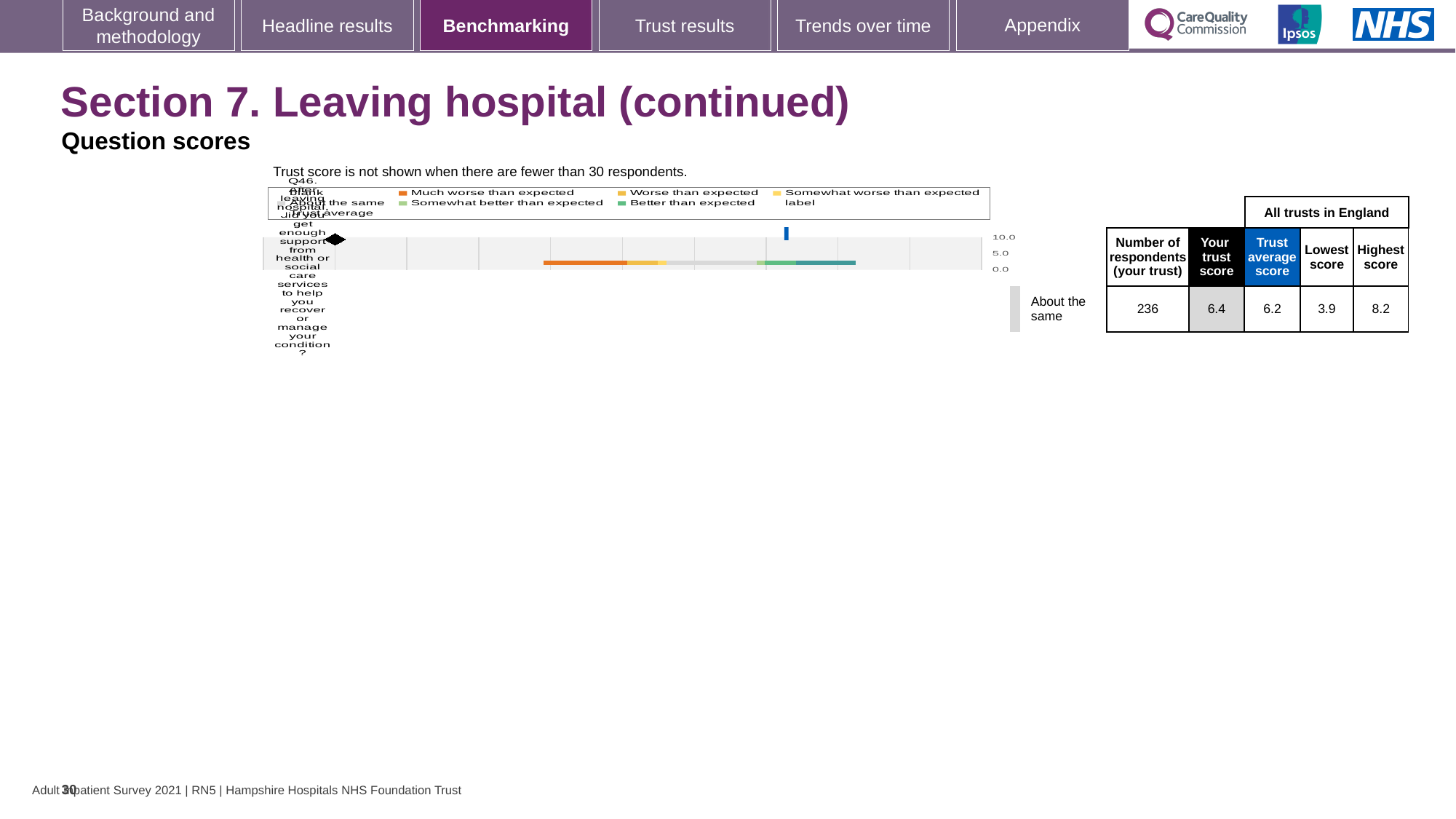
In the table next to the chart, what is the trust average score? 6.2 What is the difference between the highest score and the lowest score among all trusts in England? 4.3 What benchmark category is the trust's result for Q46 labelled as? About the same In the table next to the chart, what is the highest score among all trusts in England? 8.2 In the table next to the chart, what is the number of respondents for your trust? 236 How many question categories are plotted in the chart? 1 What is the highest tick value shown on the chart's axis? 10.0 What kind of chart is shown on the slide? bar chart Which colour does the legend use for 'Much worse than expected'? orange Which is larger, your trust score or the trust average score? your trust score In the table next to the chart, what is your trust score for Q46? 6.4 In the table next to the chart, what is the lowest score among all trusts in England? 3.9